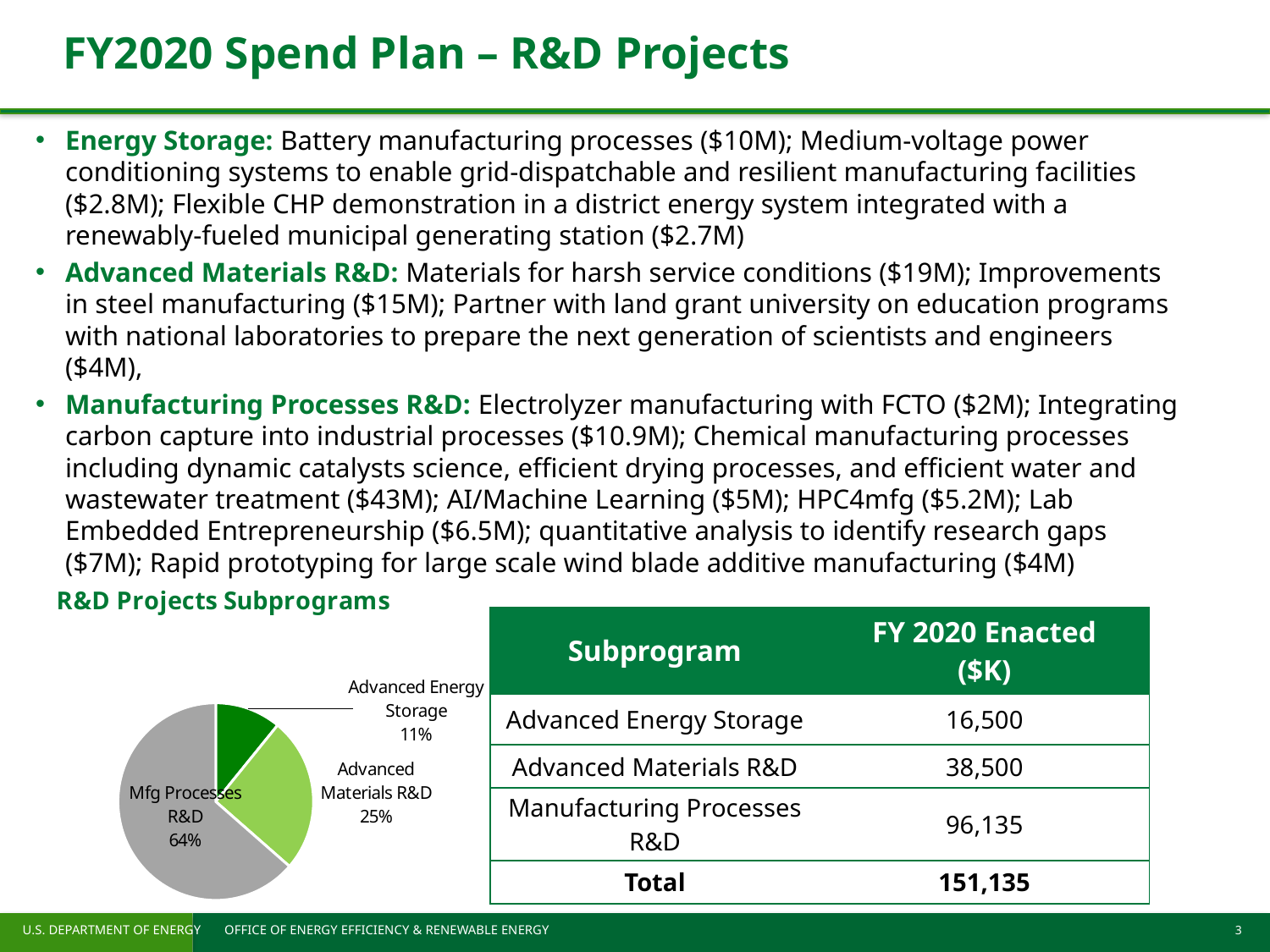
In the pie chart, what is the difference in percentage points between Mfg Processes R&D and Advanced Materials R&D? 39 percentage points What share of the pie chart does Advanced Materials R&D represent? 25% In the pie chart, which is larger: Advanced Materials R&D or Advanced Energy Storage? Advanced Materials R&D Which slice of the pie chart is the largest? Mfg Processes R&D Which slice of the pie chart is the smallest? Advanced Energy Storage What share of the pie chart does Mfg Processes R&D represent? 64% In the pie chart, what is the difference in percentage points between Advanced Materials R&D and Advanced Energy Storage? 14 percentage points How many slices does the pie chart have? 3 What share of the pie chart does Advanced Energy Storage represent? 11% What is the title shown above the pie chart? R&D Projects Subprograms What colour is the Mfg Processes R&D slice in the pie chart? Gray What kind of chart is shown under the heading "R&D Projects Subprograms"? Pie chart